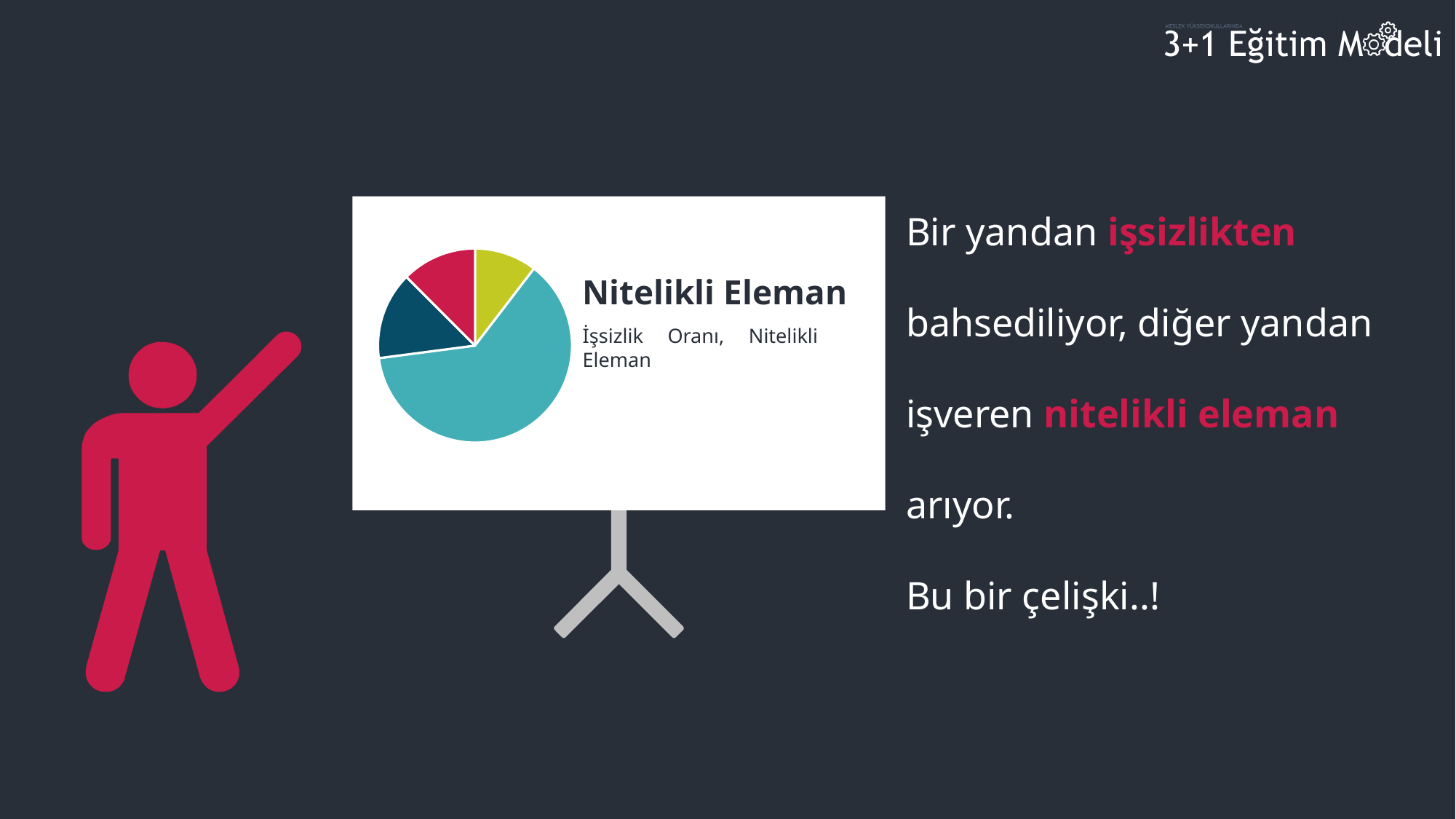
Is the teal slice of the pie chart greater or less than half of the pie? greater Which colour slice is the largest in the pie chart? Teal What kind of chart is shown on the whiteboard? Pie chart What title is printed next to the pie chart? Nitelikli Eleman How many slices does the pie chart have? 4 Does the pie chart display any data labels or a legend? No